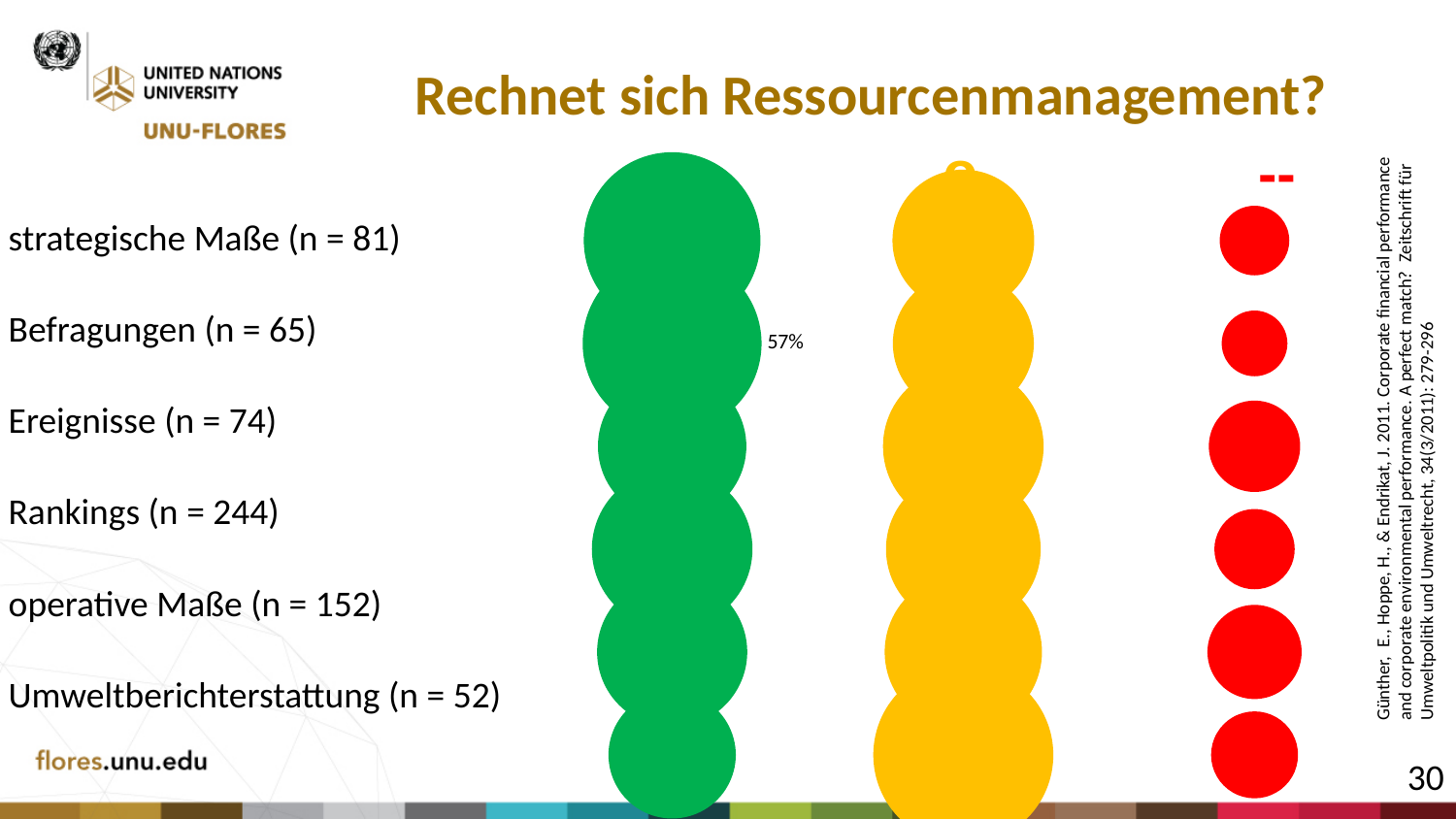
Which category has the smallest sample size (n)? Umweltberichterstattung (n = 52) What is the sample size (n) given for Rankings? 244 Which colour of circle is shown in the rightmost column of the chart? red What is the title of the slide containing the chart? Rechnet sich Ressourcenmanagement? How many colours of circles are used in the chart? 3 In the strategische Maße row, which circle is larger, the green one or the red one? the green one What is the sample size (n) given for Umweltberichterstattung? 52 How many categories (rows) are listed on the left of the chart? 6 What is the sample size (n) given for operative Maße? 152 Which category has the largest sample size (n)? Rankings (n = 244) What percentage value is printed next to the green circle in the Befragungen row? 57%